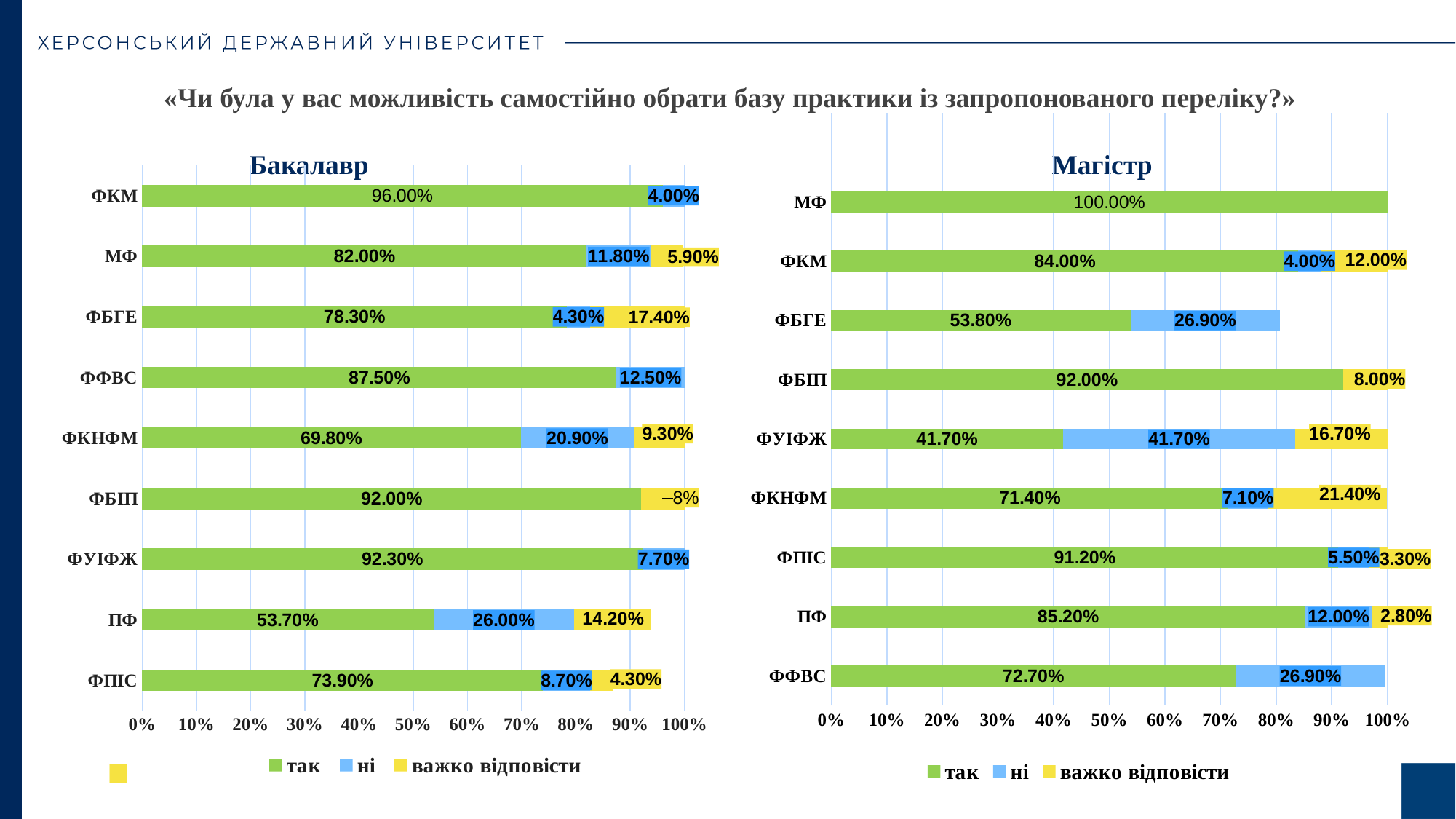
In the Бакалавр chart, what is the value of так for ФКМ? 96.00% How many series does the legend of the Магістр chart list? 3 How many categories are shown in the Бакалавр chart? 9 What are the legend entries of the Бакалавр chart? так, ні, важко відповісти What type of chart is the Магістр chart? Stacked bar chart In the Магістр chart, which category has the highest value for так? МФ In the Магістр chart, what is the total of the stacked bar for ФКМ? 100.00% In the Бакалавр chart, what is the difference between the ні value for ПФ and the ні value for ФКНФМ? 5.10% In the Магістр chart, what is the value of важко відповісти for ФКНФМ? 21.40% In the Бакалавр chart, which category has the lowest value for так? ПФ In the Бакалавр chart, what is the value of важко відповісти for ФБГЕ? 17.40% In the Магістр chart, which has a larger так value: ФБГЕ or ФФВС? ФФВС